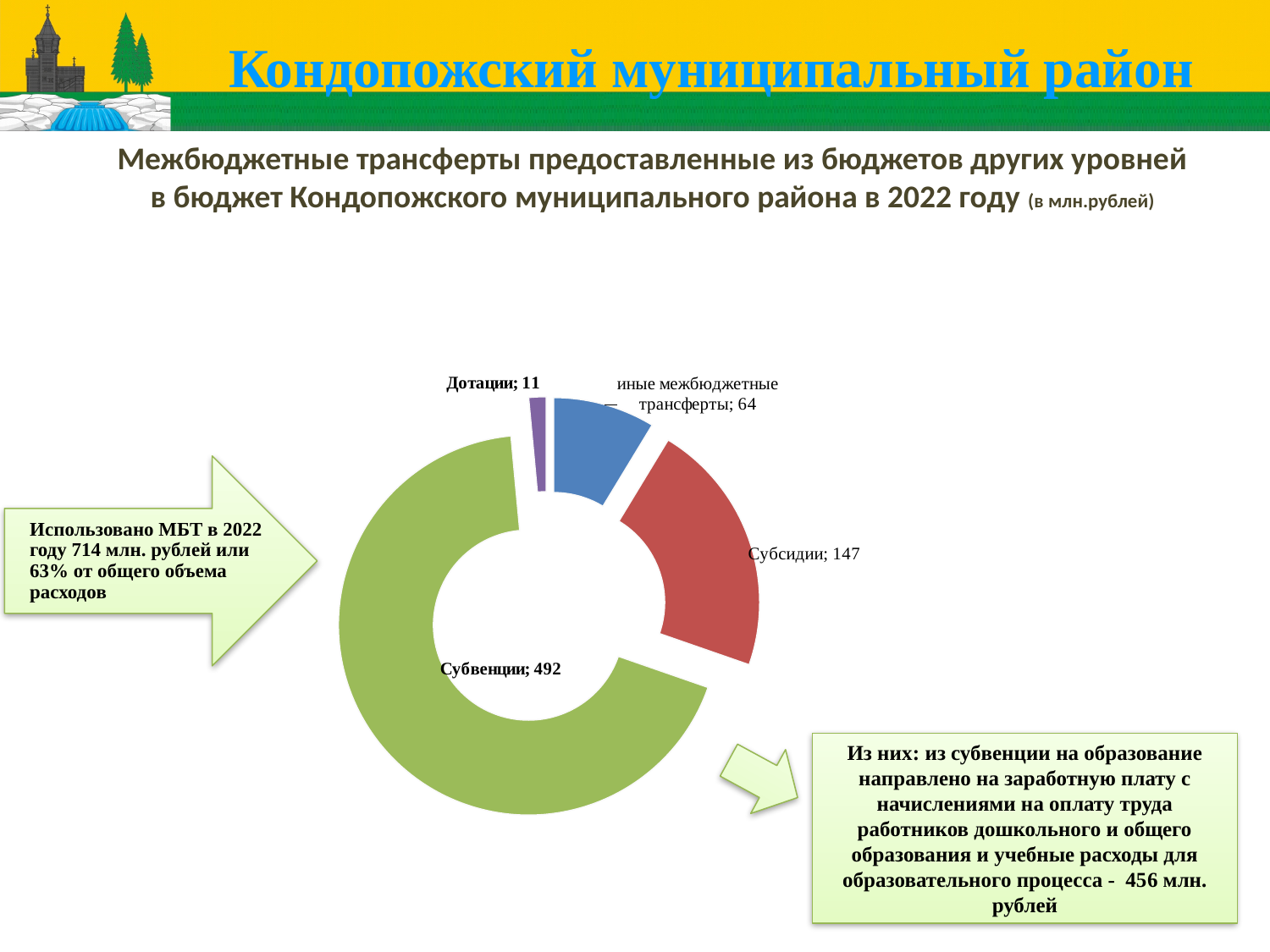
What is the value for иные межбюджетные трансферты? 64 Which category has the largest value? Субвенции What is the difference between иные межбюджетные трансферты and Дотации? 53 What is the value for Субвенции? 492 Which is larger, Субсидии or иные межбюджетные трансферты? Субсидии How many categories are shown in the chart? 4 What is the total of all four categories in the chart? 714 What is the value for Дотации? 11 What kind of chart is shown on the slide? Doughnut (pie) chart Which category has the smallest value? Дотации What is the value for Субсидии? 147 What is the difference between Субвенции and Субсидии? 345